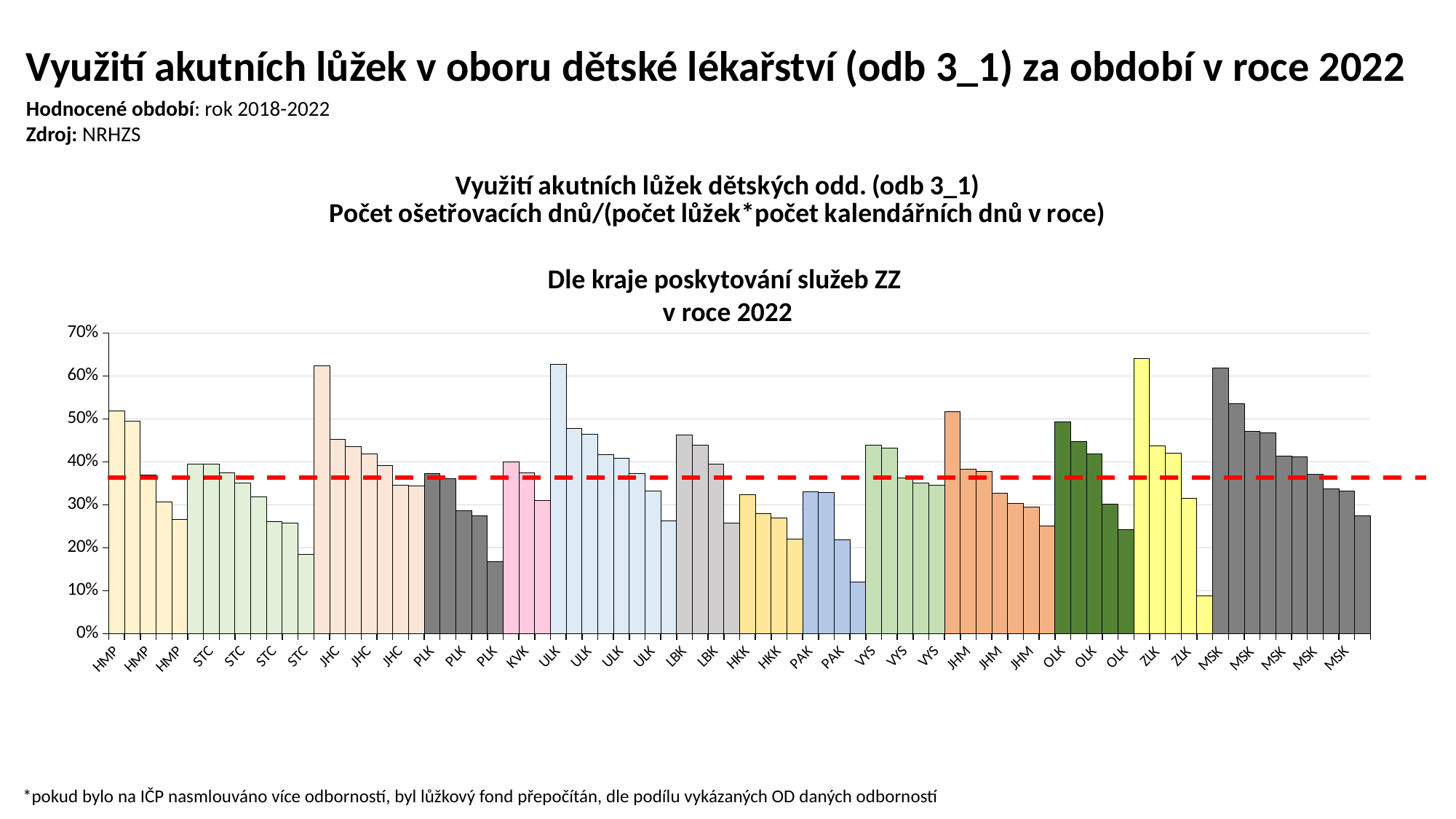
Is the value of the tallest JHC bar greater or less than 60%? greater Which region group contains the shortest bar in the chart? ZLK Is the value of the shortest PAK bar greater or less than 10%? greater How many different region abbreviations (kraje) are labelled along the x axis of the chart? 14 What is the highest value shown on the vertical axis of the chart? 70% Is the value of the tallest KVK bar greater or less than 50%? less What kind of chart is shown on the slide? bar chart Which is larger: the first (leftmost) HMP bar or the first (leftmost) STC bar? the first HMP bar Within the MSK group, do the bars rise or fall from left to right? fall